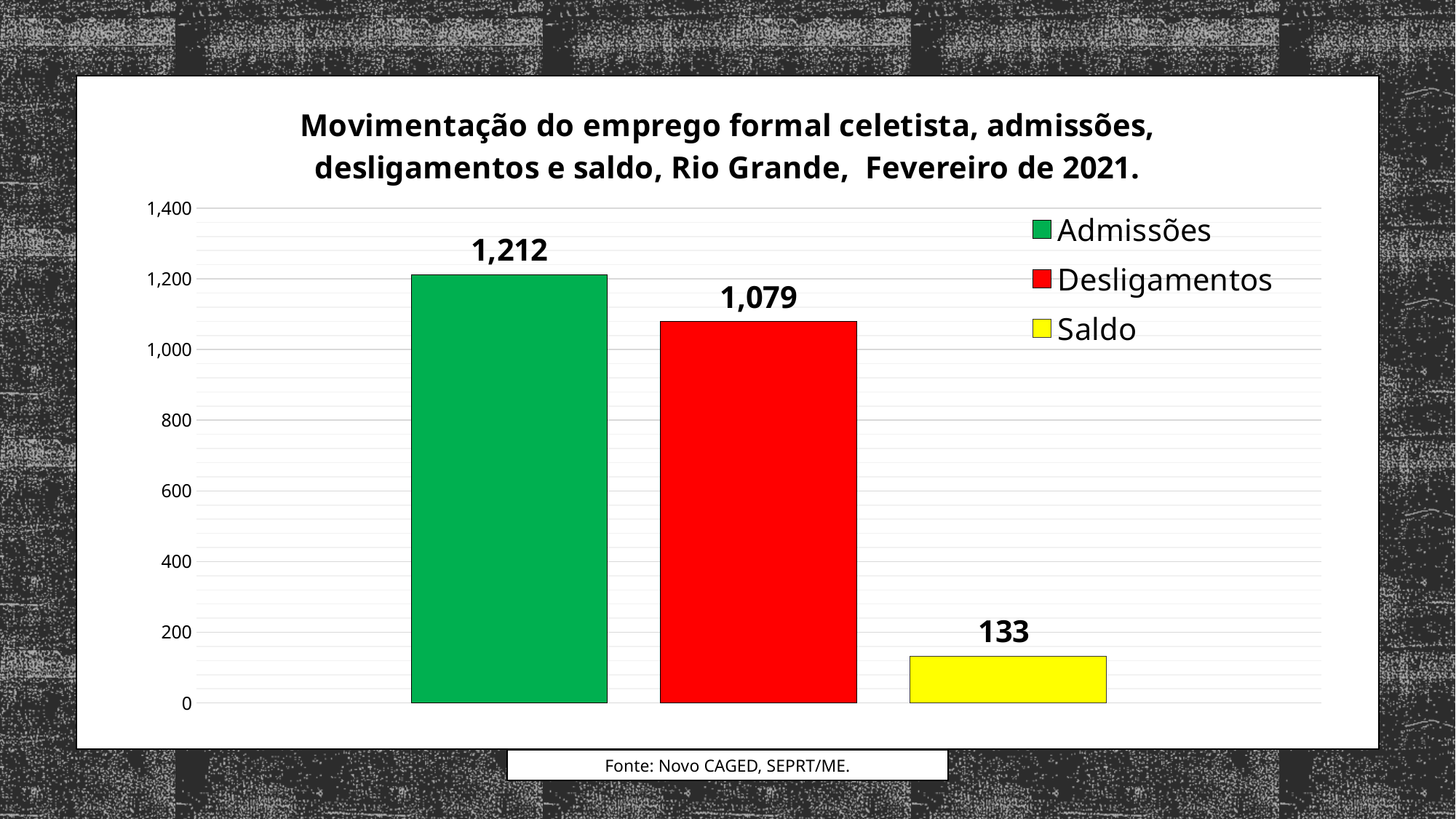
Is the value for Saldo greater or less than 200? less Which series has the highest value? Admissões What is the value for Desligamentos? 1,079 How many series does the legend list? 3 What is the value for Admissões? 1,212 Which series has the lowest value? Saldo Is the value for Desligamentos greater or less than 1,000? greater What is the difference between Admissões and Desligamentos? 133 What kind of chart is shown? Bar chart What colour is the bar for Saldo? Yellow Which is larger, Admissões or Desligamentos? Admissões What is the value for Saldo? 133